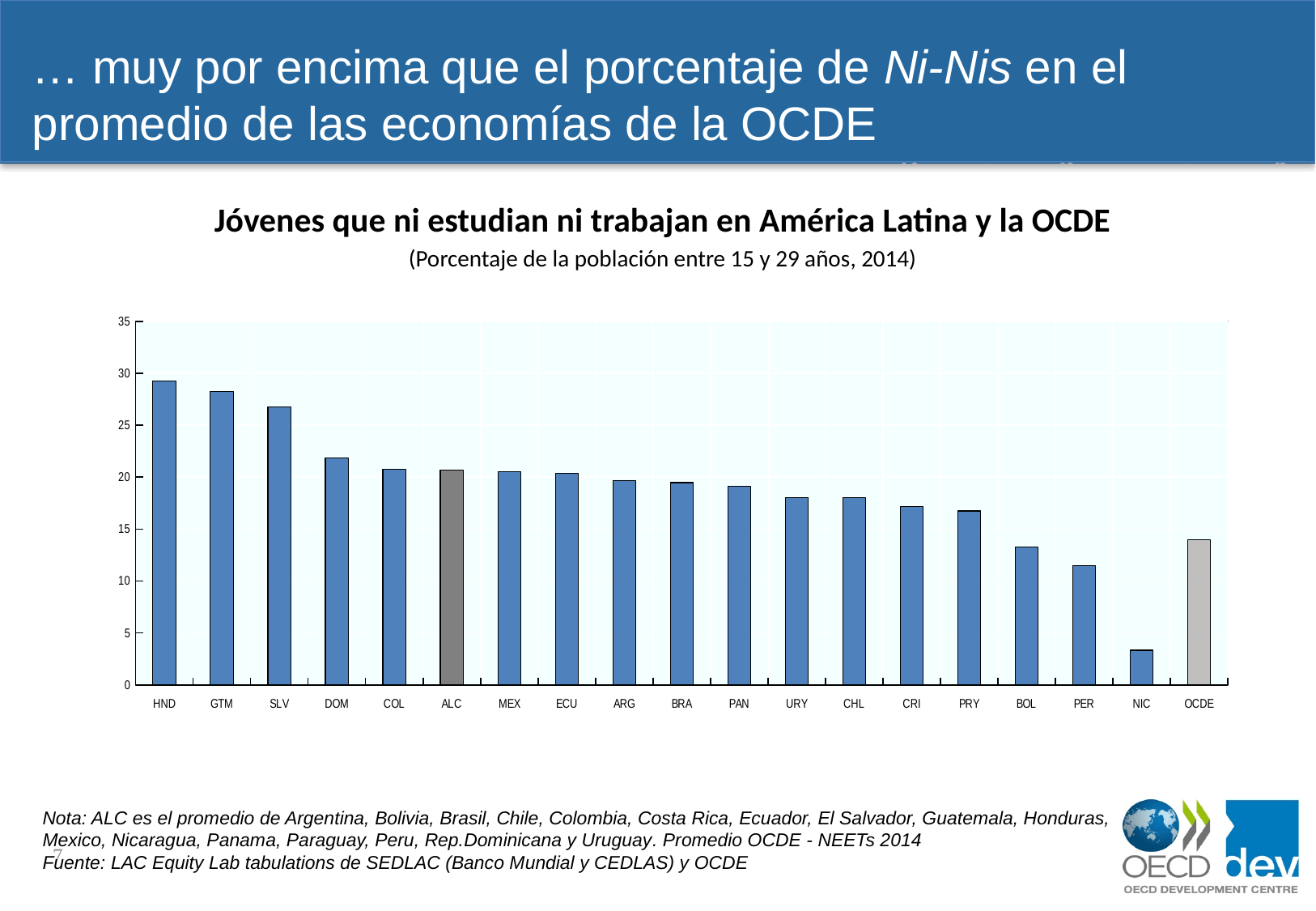
Which category has the lowest value in the chart? NIC Which category has the highest value in the chart? HND How many categories are shown on the x axis of the chart? 19 What kind of chart is shown on the slide? bar chart Is the value for OCDE greater or less than 15? less Is the value for HND greater or less than 25? greater Is the value for NIC greater or less than 5? less Which is larger, the value for HND or the value for OCDE? HND What is the title of the chart? Jóvenes que ni estudian ni trabajan en América Latina y la OCDE Which is larger, the value for NIC or the value for PER? PER